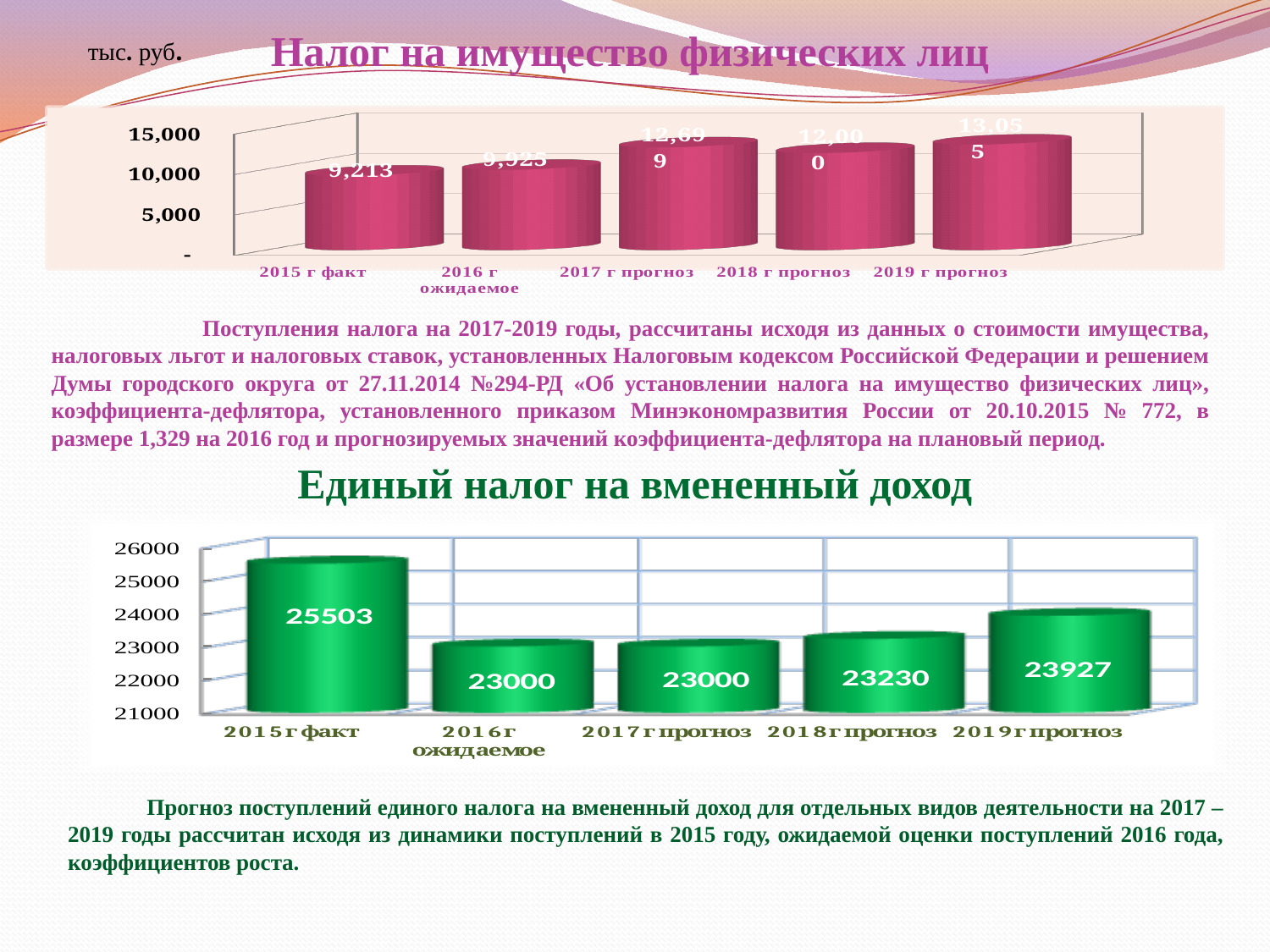
In the chart titled 'Единый налог на вмененный доход', what is the value for '2018 г прогноз'? 23230 In the chart titled 'Налог на имущество физических лиц', how many categories are shown on the x axis? 5 In the chart titled 'Единый налог на вмененный доход', what is the difference between the values for '2015 г факт' and '2016 г ожидаемое'? 2503 In the chart titled 'Единый налог на вмененный доход', what is the value for '2015 г факт'? 25503 In the chart titled 'Налог на имущество физических лиц', what is the value for '2016 г ожидаемое'? 9,925 In the chart titled 'Налог на имущество физических лиц', what is the value for '2015 г факт'? 9,213 In the chart titled 'Единый налог на вмененный доход', which is larger: the value for '2018 г прогноз' or '2019 г прогноз'? 2019 г прогноз In the chart titled 'Налог на имущество физических лиц', is the value for '2019 г прогноз' greater or less than 10,000? greater In the chart titled 'Налог на имущество физических лиц', what unit is indicated at the top left of the slide? тыс. руб. In the chart titled 'Единый налог на вмененный доход', which category has the highest value? 2015 г факт In the chart titled 'Единый налог на вмененный доход', what is the value for '2019 г прогноз'? 23927 What type of chart is the chart titled 'Единый налог на вмененный доход'? bar chart